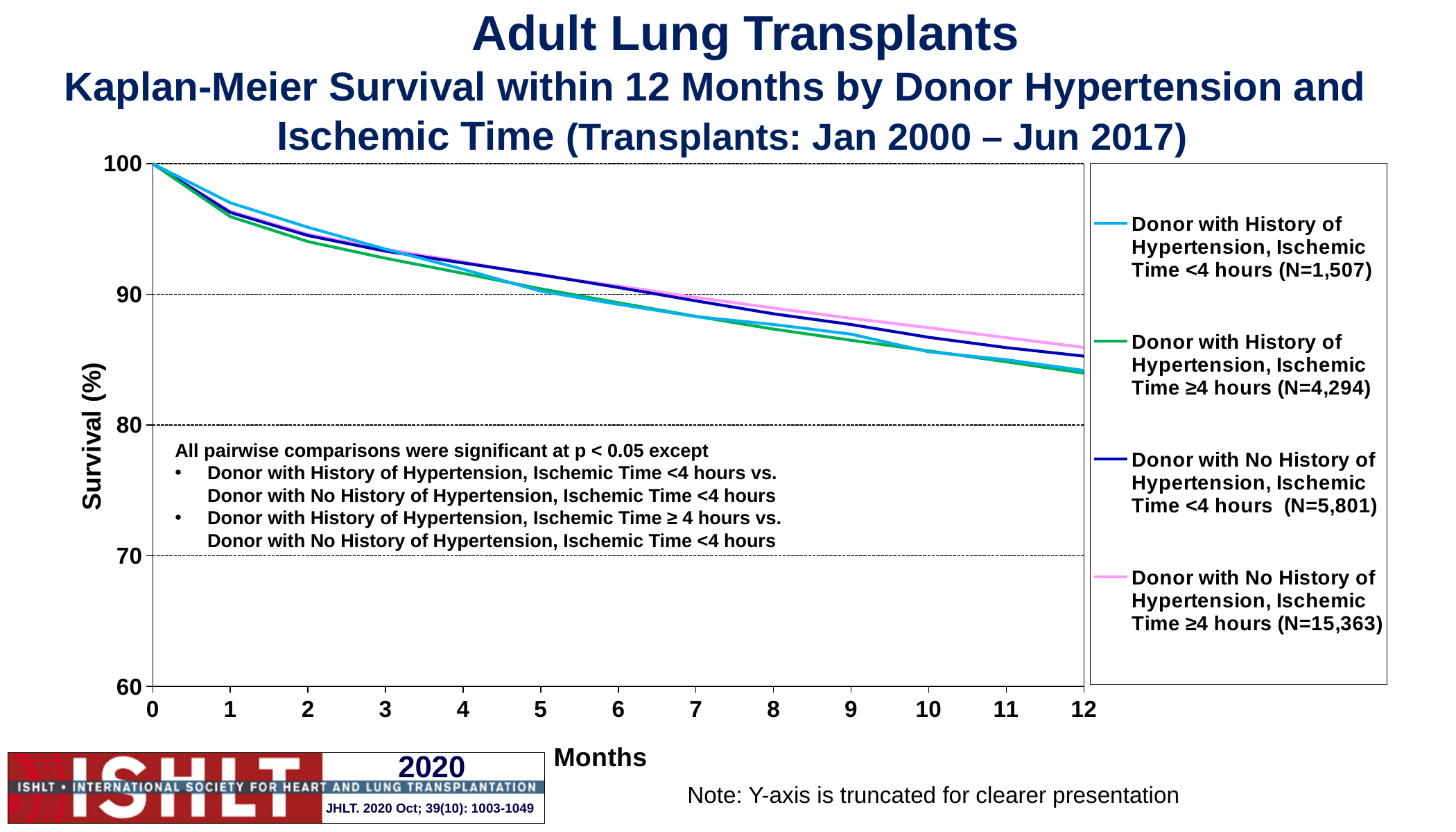
Which series has the largest N in the legend? Donor with No History of Hypertension, Ischemic Time ≥4 hours (N=15,363) What is the N for the series Donor with History of Hypertension, Ischemic Time <4 hours? N=1,507 At 12 months, is the survival for Donor with History of Hypertension, Ischemic Time ≥4 hours greater or less than 90? less How many series does the legend list? 4 Do the survival curves rise or fall as months increase along the x axis? Fall Which series has the highest survival at 12 months? Donor with No History of Hypertension, Ischemic Time ≥4 hours At 3 months, is the survival for Donor with History of Hypertension, Ischemic Time ≥4 hours greater or less than 90? greater What is the maximum value shown on the x axis (Months)? 12 What is the survival (%) for all series at month 0? 100 At 12 months, which has higher survival: Donor with No History of Hypertension, Ischemic Time ≥4 hours or Donor with History of Hypertension, Ischemic Time ≥4 hours? Donor with No History of Hypertension, Ischemic Time ≥4 hours At 12 months, is the survival for Donor with No History of Hypertension, Ischemic Time ≥4 hours greater or less than 80? greater What kind of chart is shown on the slide? Line chart